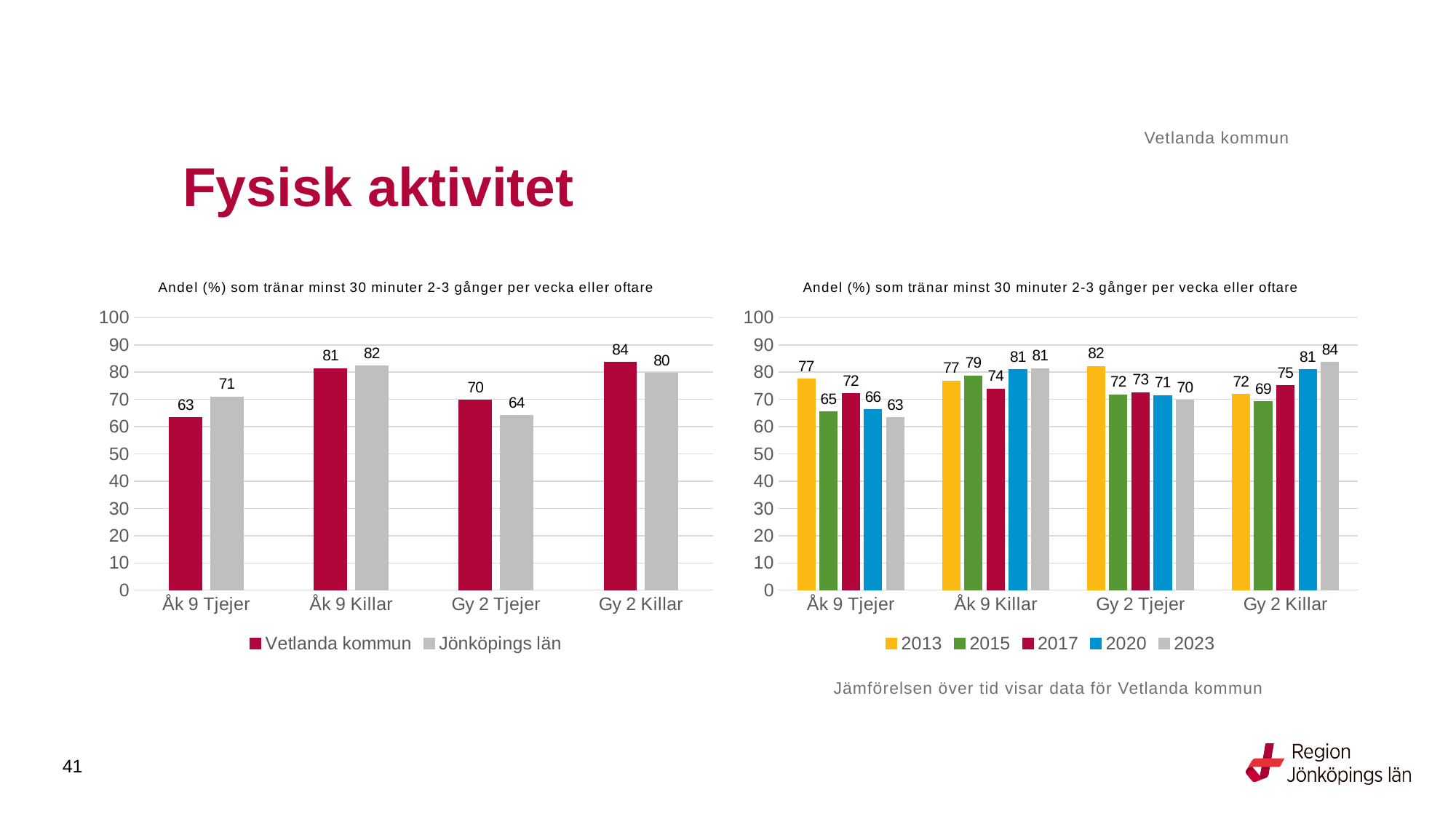
In the left chart, what is the value for Vetlanda kommun for Åk 9 Tjejer? 63 In the right chart, what is the difference between 2013 and 2023 for Gy 2 Tjejer? 12 In the left chart, which category has the lowest value for Jönköpings län? Gy 2 Tjejer In the right chart, what is the value for 2015 for Åk 9 Tjejer? 65 In the right chart, what is the value for 2023 for Gy 2 Killar? 84 In the left chart, what is the difference between Vetlanda kommun and Jönköpings län for Åk 9 Tjejer? 8 In the left chart, which category has the highest value for Vetlanda kommun? Gy 2 Killar How many series does the legend of the right chart list? 5 In the right chart, which year has the lowest value for Gy 2 Killar? 2015 In the left chart, which is larger for Gy 2 Tjejer: Vetlanda kommun or Jönköpings län? Vetlanda kommun What type of chart is the left chart? Bar chart In the left chart, what is the value for Jönköpings län for Gy 2 Killar? 80